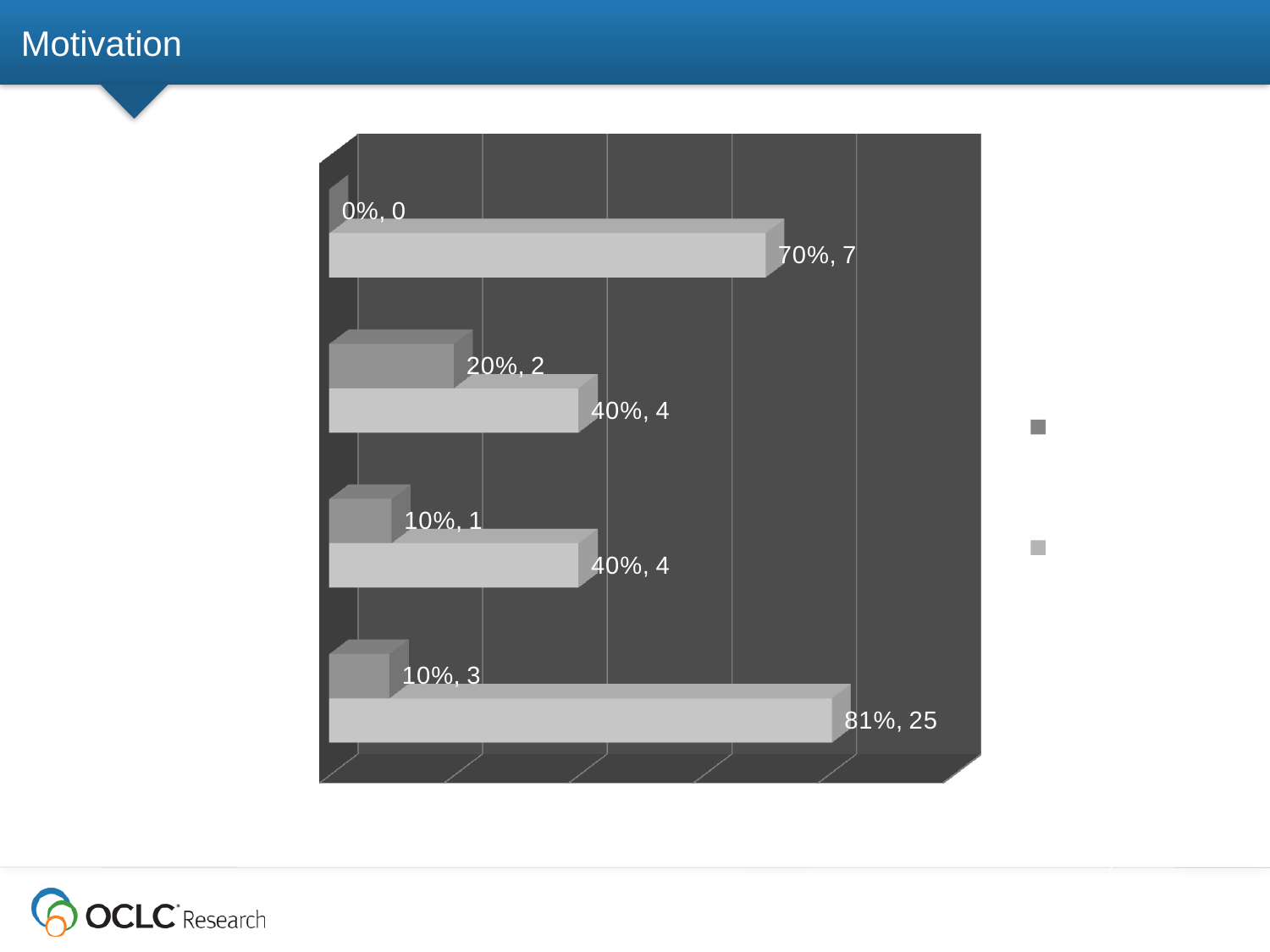
How many groups of bars does the chart show? 4 How many series does the legend list? 2 What is the data label on the darker grey bar in the third group from the top? 10%, 1 Which group has the shortest darker grey bar? the top group What kind of chart is shown on the slide? bar chart Which group has the longest lighter grey bar? the bottom group What is the data label on the lighter grey bar in the top group? 70%, 7 In the second group from the top, which bar is larger, the darker grey bar or the lighter grey bar? the lighter grey bar What is the data label on the lighter grey bar in the bottom group? 81%, 25 What is the data label on the darker grey bar in the top group? 0%, 0 In the second group from the top, what is the difference in percentage between the lighter grey bar and the darker grey bar? 20% What is the data label on the darker grey bar in the second group from the top? 20%, 2